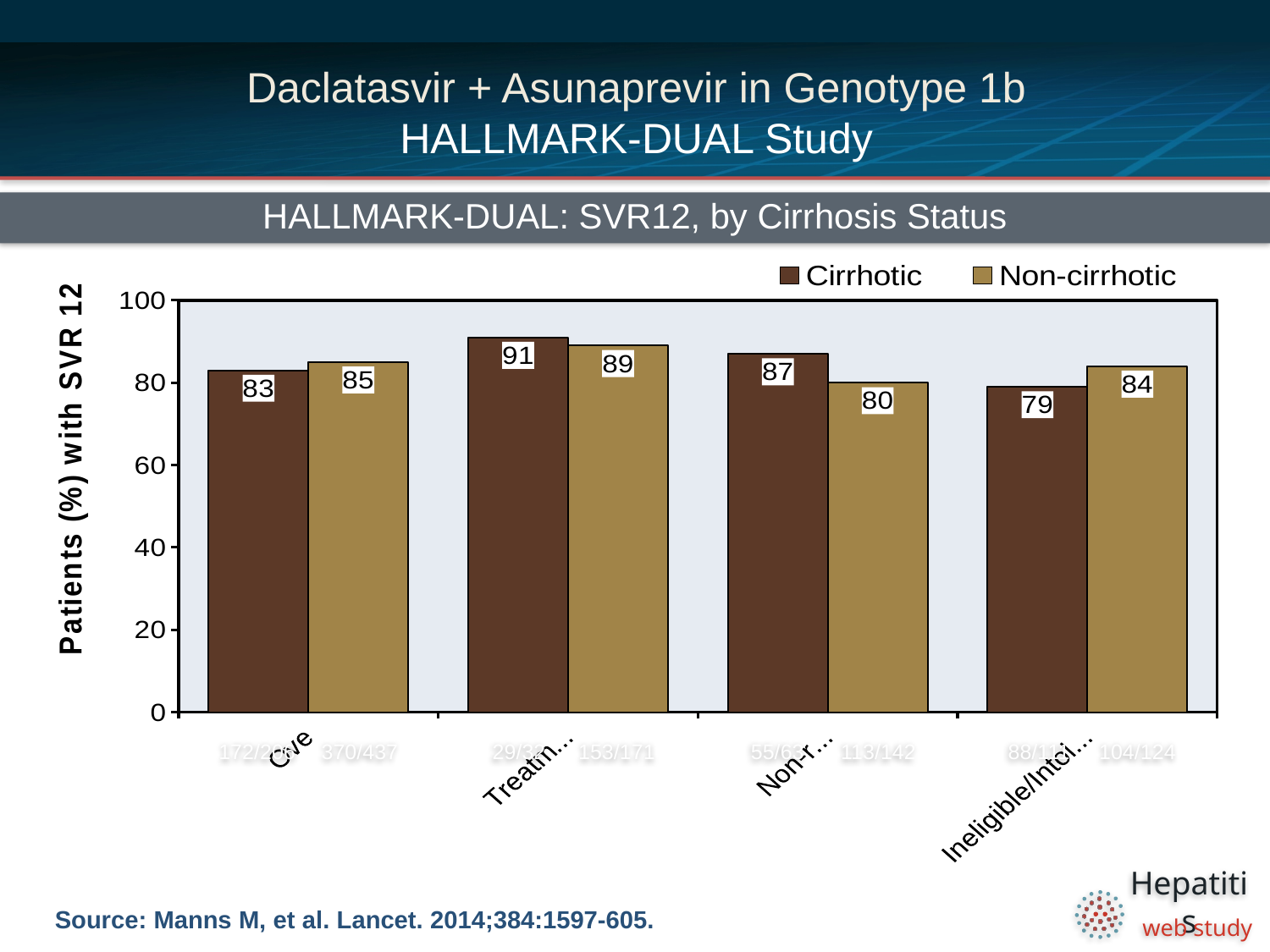
What is the Non-cirrhotic value for the third group of bars from the left? 80 How many groups of bars are plotted along the x axis? 4 What kind of chart is shown on the slide? bar chart What is the lowest Cirrhotic value shown on the chart? 79 In the third group of bars from the left, what is the difference between the Cirrhotic and Non-cirrhotic values? 7 How many series does the legend list? 2 Which group of bars has the highest Cirrhotic value? the second group from the left In the rightmost group of bars, which series has the larger value, Cirrhotic or Non-cirrhotic? Non-cirrhotic What is the Non-cirrhotic value for the rightmost group of bars? 84 What is the title of the y axis? Patients (%) with SVR 12 What is the Cirrhotic value for the leftmost group of bars? 83 What is the Cirrhotic value for the second group of bars from the left? 91